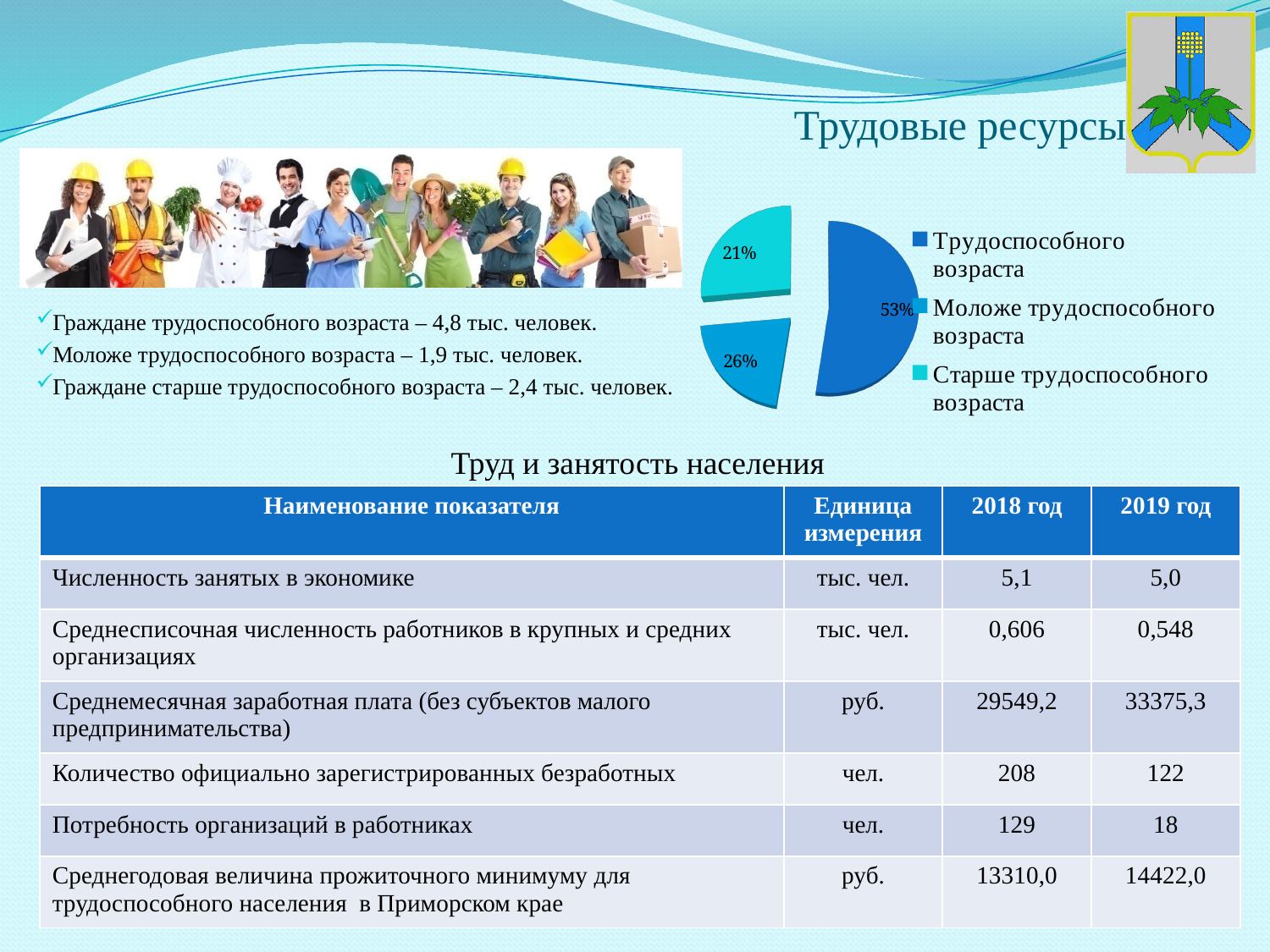
Which is larger, the slice labelled 26% or the slice labelled 21%? the slice labelled 26% Is the share for Трудоспособного возраста greater or less than 50%? greater How many slices does the pie chart have? 3 What is the difference in percentage points between the largest slice (53%) and the smallest slice (21%)? 32 What is the value printed on the smallest slice of the pie chart? 21% What kind of chart is shown on the slide? pie chart What is the first entry listed in the pie chart's legend? Трудоспособного возраста How many entries does the legend of the pie chart list? 3 What colour is the slice for Трудоспособного возраста in the pie chart? dark blue What share of the pie does the slice for Трудоспособного возраста represent? 53% Which category has the largest slice in the pie chart? Трудоспособного возраста